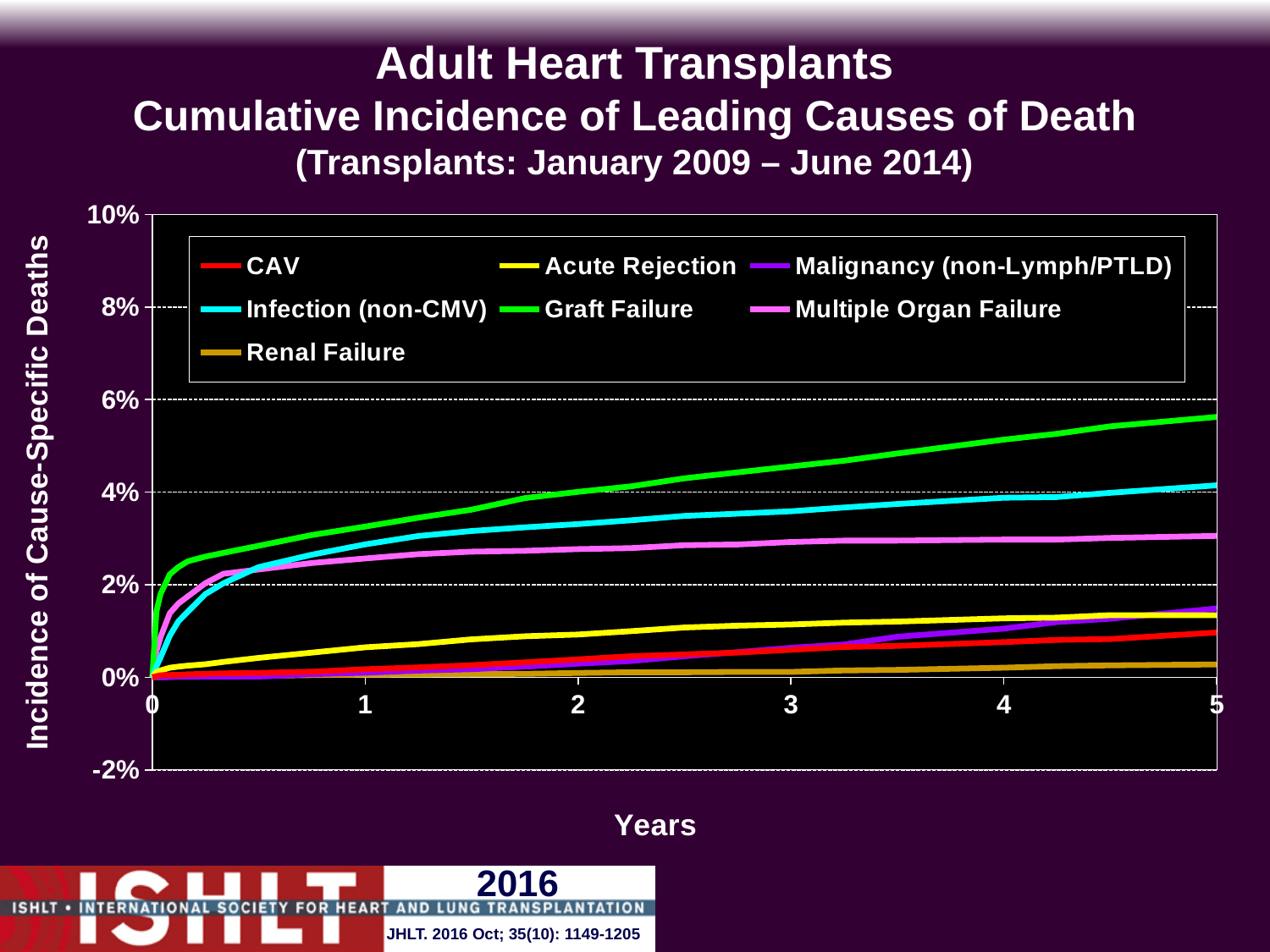
What kind of chart is shown on the slide? Line chart Is the cumulative incidence for Graft Failure at 5 years greater or less than 4%? greater Is the cumulative incidence for Acute Rejection at 5 years greater or less than 2%? less Is the cumulative incidence for Multiple Organ Failure at 5 years greater or less than 2%? greater How many series does the legend list? 7 At 5 years, which is larger: the cumulative incidence for Multiple Organ Failure or for Acute Rejection? Multiple Organ Failure Which cause of death has the lowest cumulative incidence at 5 years? Renal Failure Does the cumulative incidence for Graft Failure rise or fall over the years shown? Rise Which cause of death has the highest cumulative incidence at 5 years? Graft Failure What is the label of the x axis? Years At 5 years, which is larger: the cumulative incidence for Graft Failure or for Infection (non-CMV)? Graft Failure